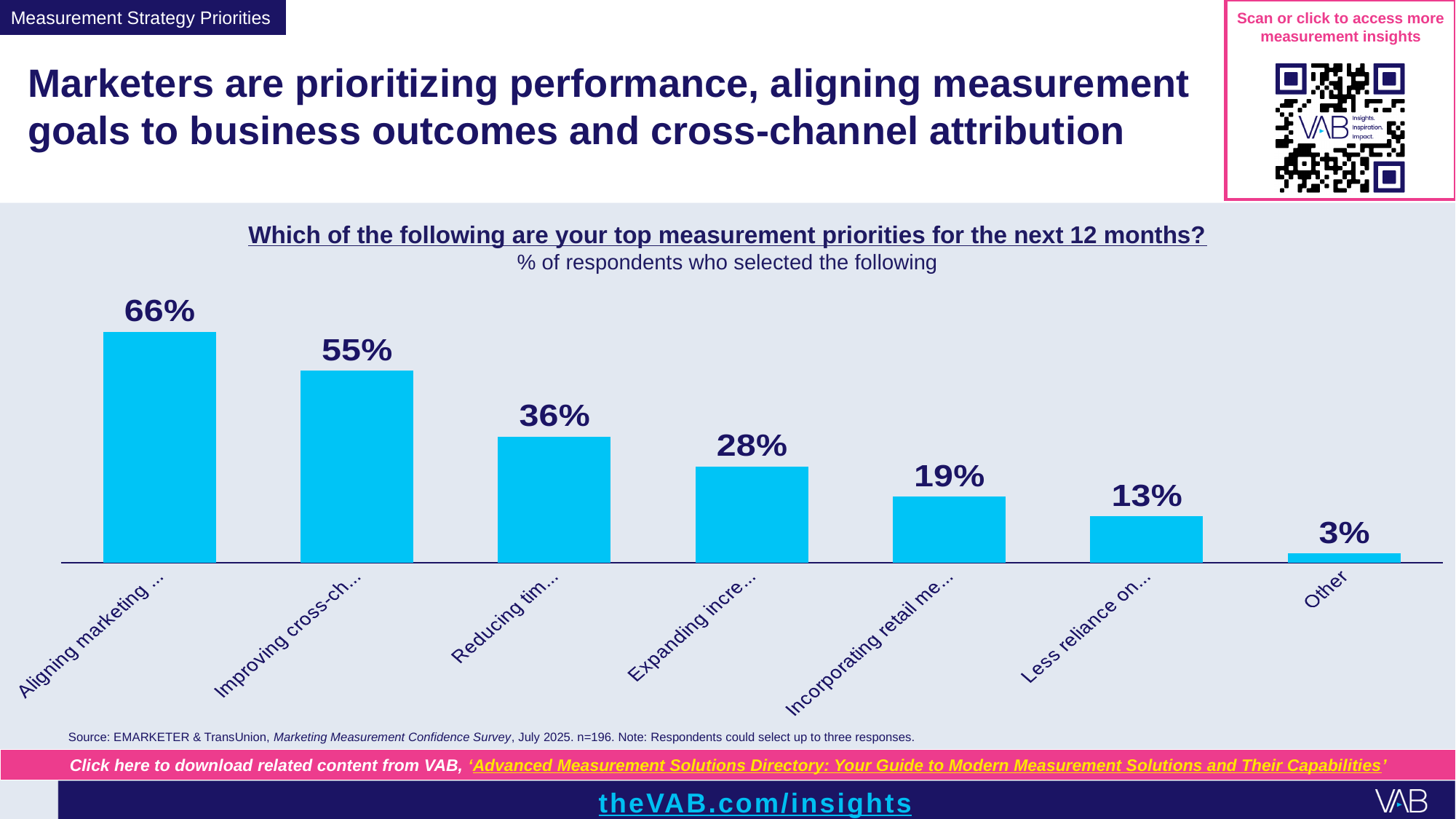
What is the difference between the third bar (36%) and the 'Other' bar (3%)? 33% What is the value for the 'Other' category? 3% Do the values rise or fall moving from left to right along the x axis? fall What is the value of the first (leftmost) bar in the chart? 66% Which category has the lowest value in the chart? Other What is the difference between the first bar (66%) and the second bar (55%)? 11% What kind of chart is shown on the slide? bar chart What is the value of the second bar from the left in the chart? 55% What is the subtitle shown under the chart's question title? % of respondents who selected the following How many bars (categories) are plotted in the chart? 7 What is the value of the fourth bar from the left in the chart? 28% What is the highest value shown in the chart? 66%